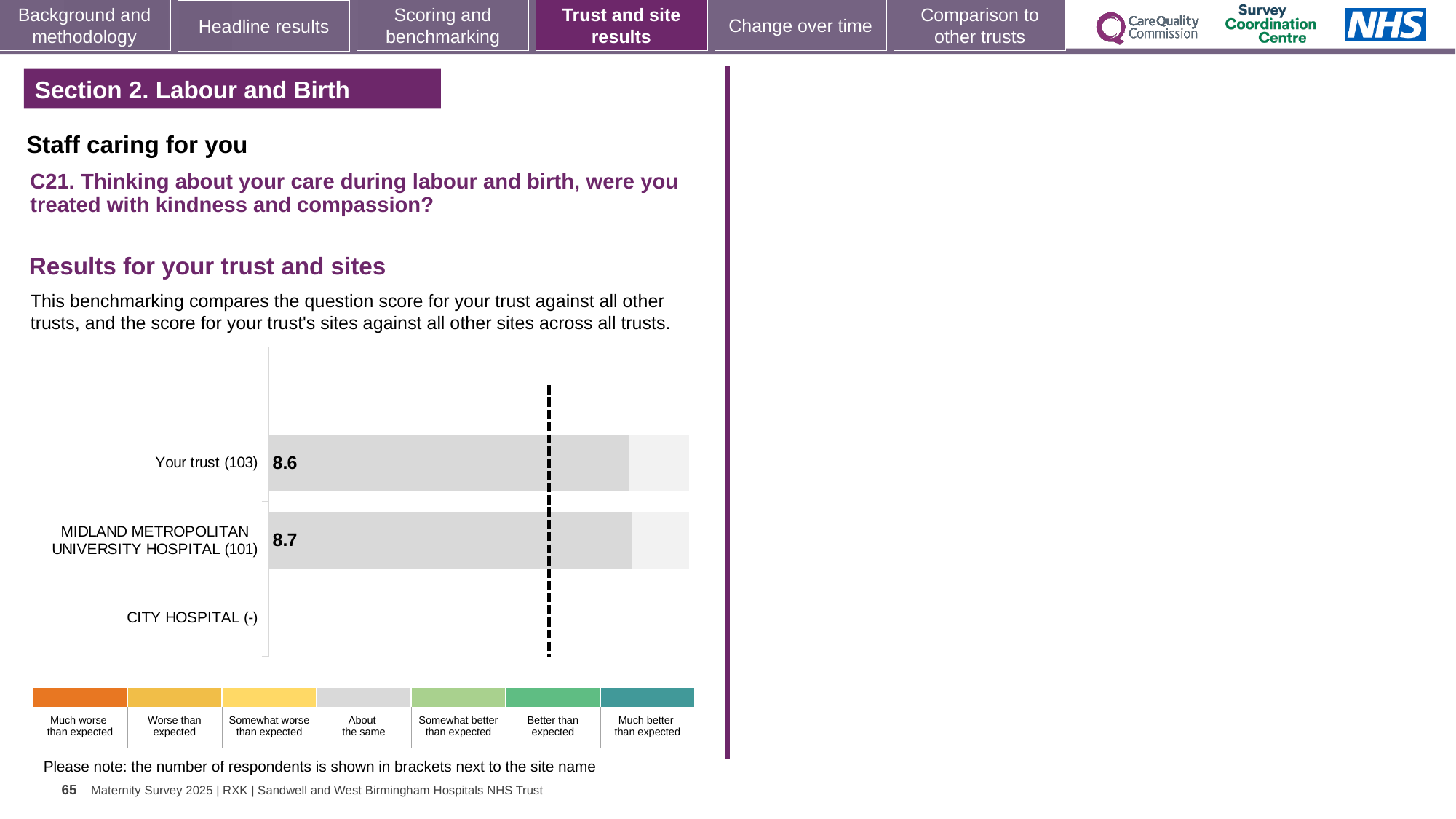
How many respondents are shown in brackets for MIDLAND METROPOLITAN UNIVERSITY HOSPITAL? 101 What is the score for Your trust (103)? 8.6 What is the difference between the score for MIDLAND METROPOLITAN UNIVERSITY HOSPITAL (101) and the score for Your trust (103)? 0.1 How many benchmark categories are shown in the colour key below the chart? 7 Which category has the highest score shown on the chart? MIDLAND METROPOLITAN UNIVERSITY HOSPITAL (101) Which category on the chart has no bar plotted? CITY HOSPITAL (-) How many categories are listed on the chart's vertical axis? 3 Which is larger: the score for Your trust (103) or the score for MIDLAND METROPOLITAN UNIVERSITY HOSPITAL (101)? MIDLAND METROPOLITAN UNIVERSITY HOSPITAL (101) How many respondents are shown in brackets for Your trust? 103 What kind of chart is shown on the slide? Bar chart Which question is the chart reporting results for? C21. Thinking about your care during labour and birth, were you treated with kindness and compassion? What is the score for MIDLAND METROPOLITAN UNIVERSITY HOSPITAL (101)? 8.7